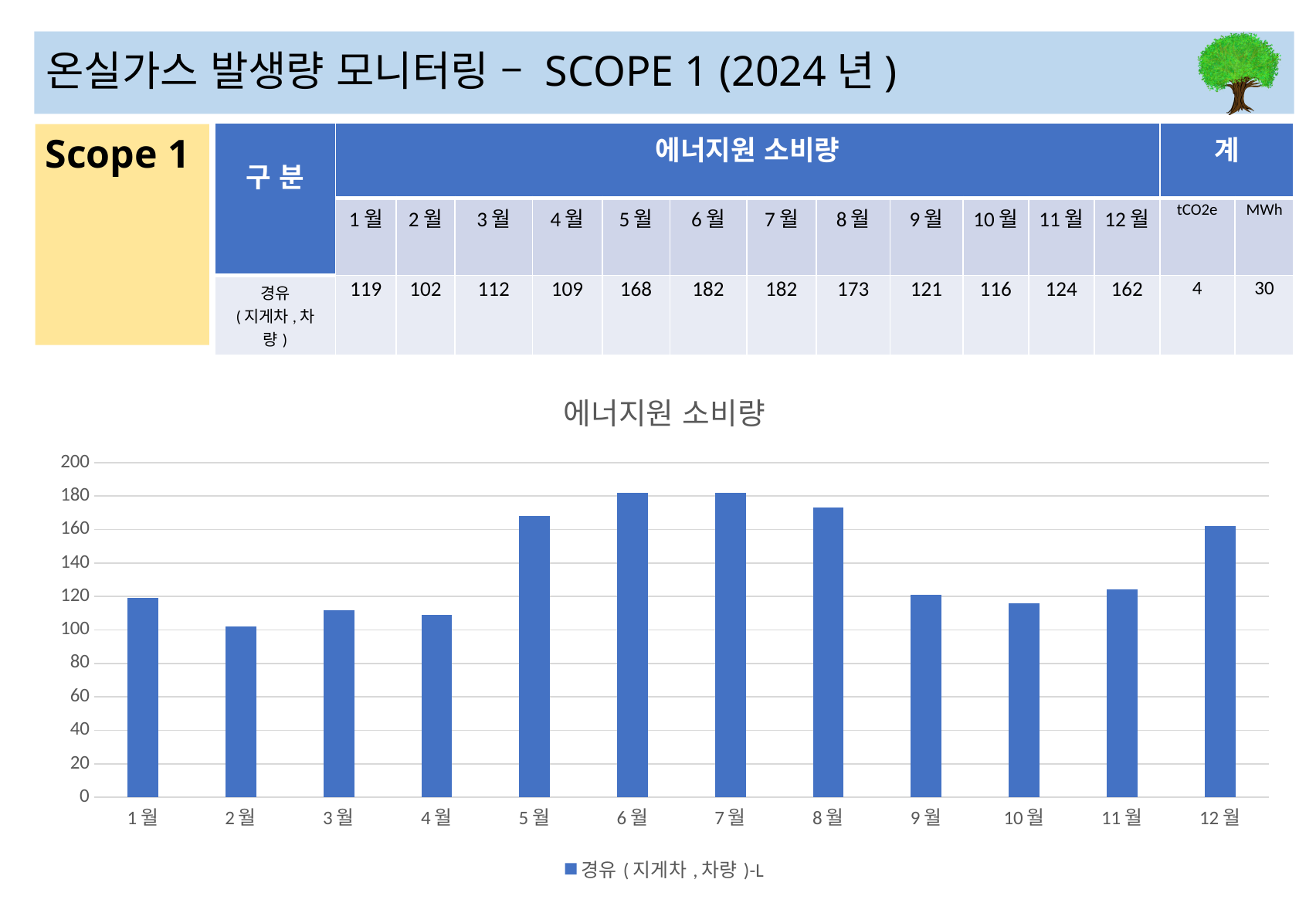
What type of chart is shown on the slide? bar chart Which is larger, the value for 12 월 or the value for 8 월? 8 월 What is the value for 6 월 in the chart? 182 Is the value for 5 월 greater or less than 160? greater How many months are shown on the x axis of the chart? 12 How many series does the chart legend list? 1 What is the difference between the values for 7 월 and 9 월? 61 What is the legend entry for the series in the chart? 경유 ( 지게차 , 차량 )-L What is the value for 2 월 in the chart? 102 Which month has the lowest value in the chart? 2 월 Do the values rise or fall from 8 월 to 10 월? fall What is the title of the chart? 에너지원 소비량